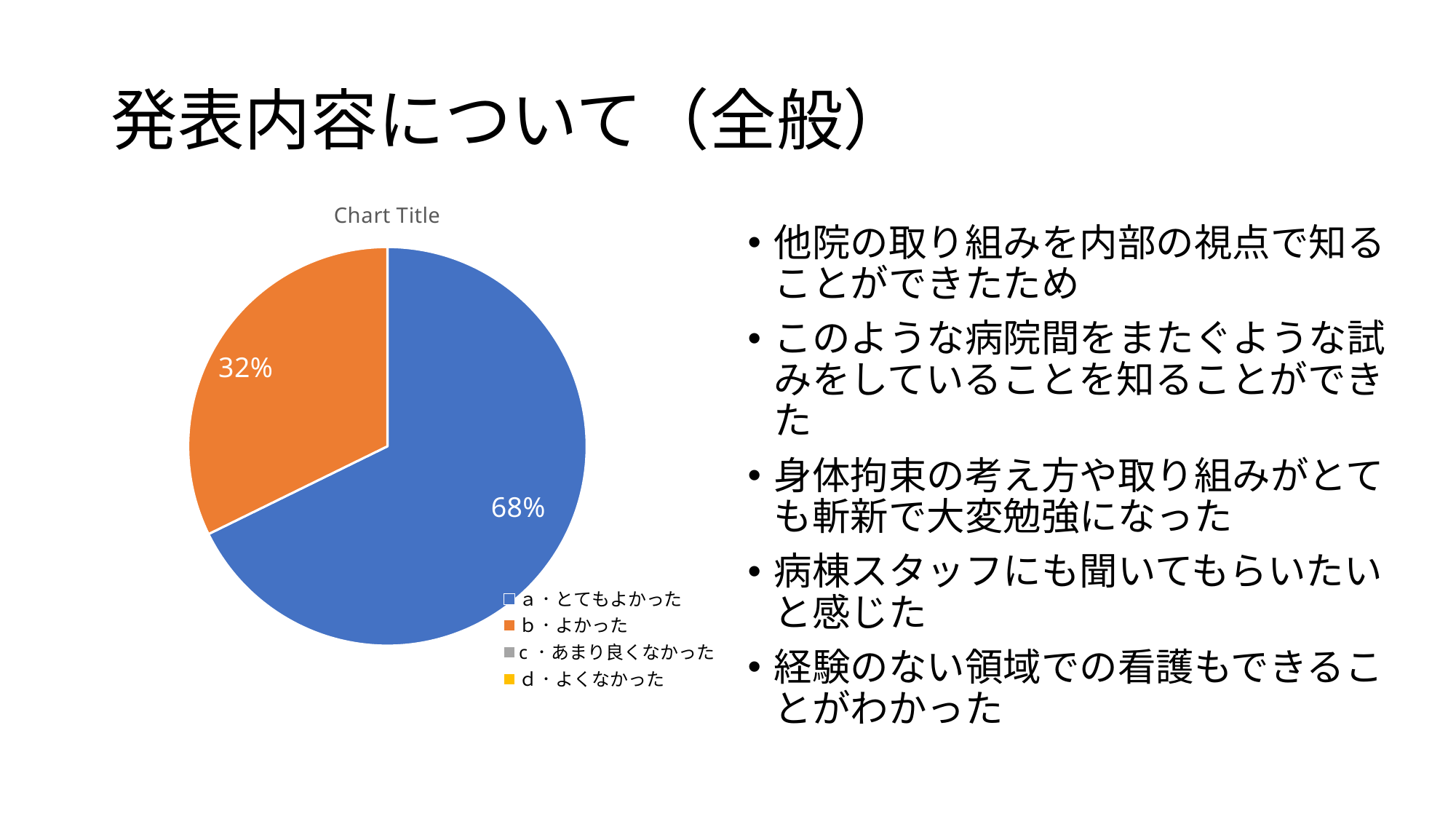
Which of the two visible slices is larger, "a・とてもよかった" or "b・よかった"? a・とてもよかった Which category has the largest slice of the pie? a・とてもよかった What is the title shown above the pie chart? Chart Title How many slices are visible in the pie? 2 Is the share for "b・よかった" greater or less than 50%? less What is the difference in percentage points between the "a・とてもよかった" slice and the "b・よかった" slice? 36 What share of the pie does "a・とてもよかった" take? 68% What kind of chart is shown on the slide? pie chart What share of the pie does "b・よかった" take? 32% What colour is the slice for "b・よかった"? orange How many entries does the legend list? 4